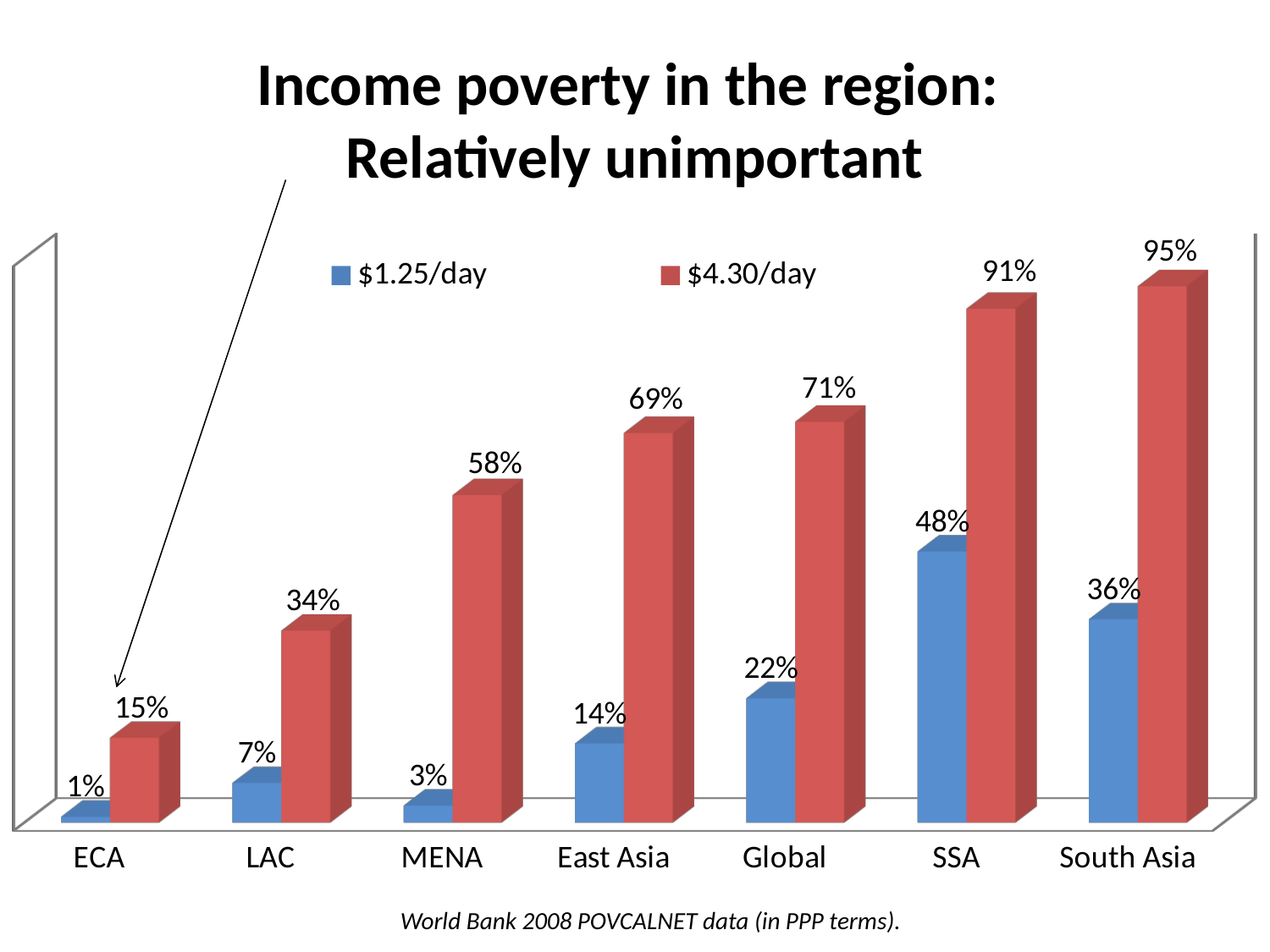
Which region has the highest $4.30/day value? South Asia What kind of chart is shown on the slide? bar chart What is the $1.25/day value for ECA? 1% What is the difference between the $4.30/day and $1.25/day values for Global? 49% Which is larger: the $1.25/day value for East Asia or the $1.25/day value for LAC? East Asia Which region has the lowest $1.25/day value? ECA What is the $4.30/day value for MENA? 58% How many series does the legend list? 2 What is the difference between the $4.30/day values for SSA and LAC? 57% What is the $1.25/day value for SSA? 48% How many regions are shown on the x axis? 7 Which colour represents the $4.30/day series? red